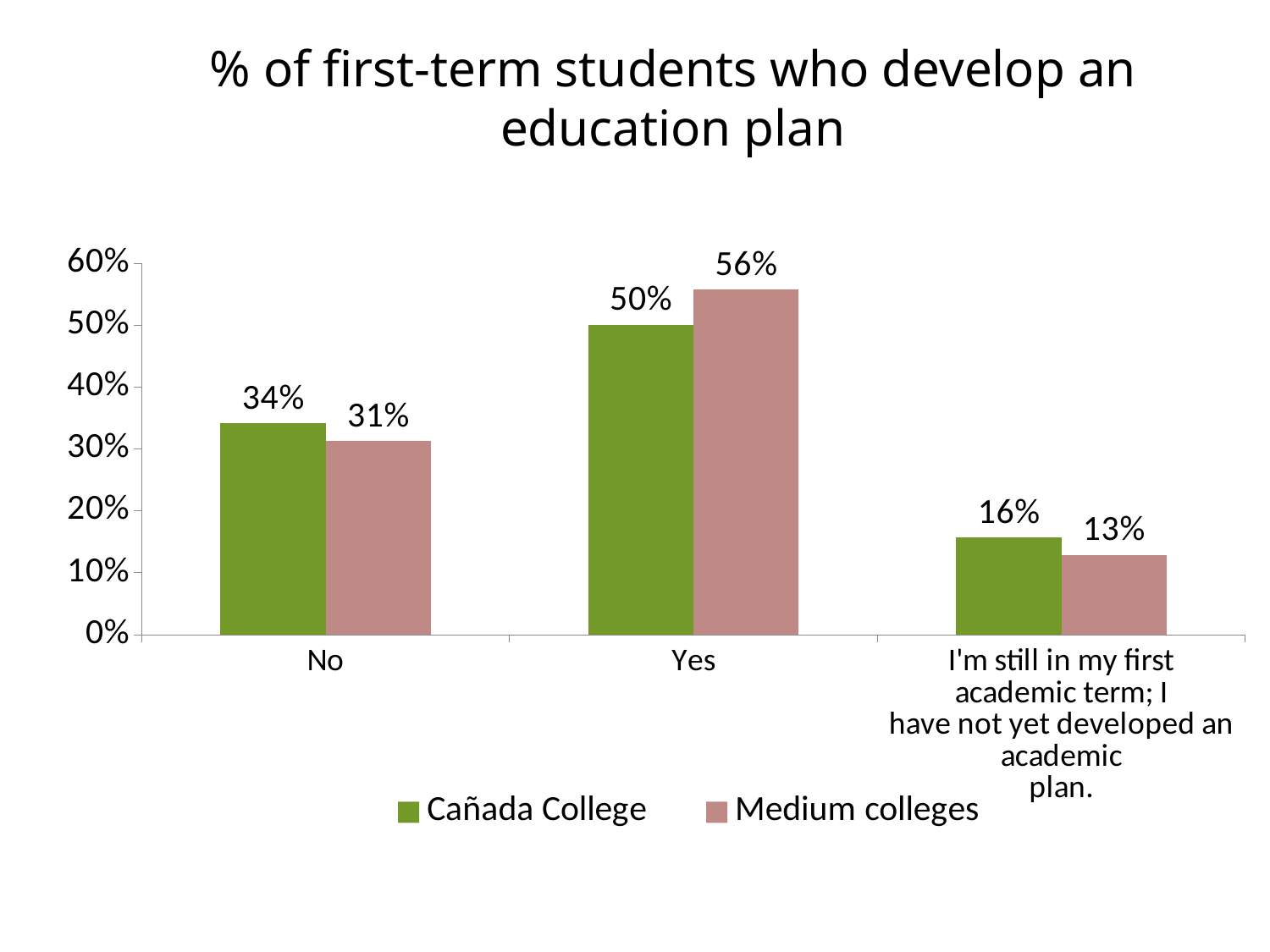
What is the title of the chart? % of first-term students who develop an education plan What kind of chart is shown on the slide? Bar chart In the "No" category, which series has the larger value, Cañada College or Medium colleges? Cañada College Which category has the highest value for Cañada College? Yes How many series does the legend list? 2 Which category has the lowest value for Medium colleges? I'm still in my first academic term; I have not yet developed an academic plan. What is the difference between Cañada College and Medium colleges in the "No" category? 3% How many categories are shown on the x axis? 3 What percentage of Cañada College first-term students answered "Yes" to developing an education plan? 50% What is the difference between Medium colleges and Cañada College in the "Yes" category? 6% What is the value for Medium colleges in the "No" category? 31% What is the value for Medium colleges for students still in their first academic term who have not yet developed a plan? 13%